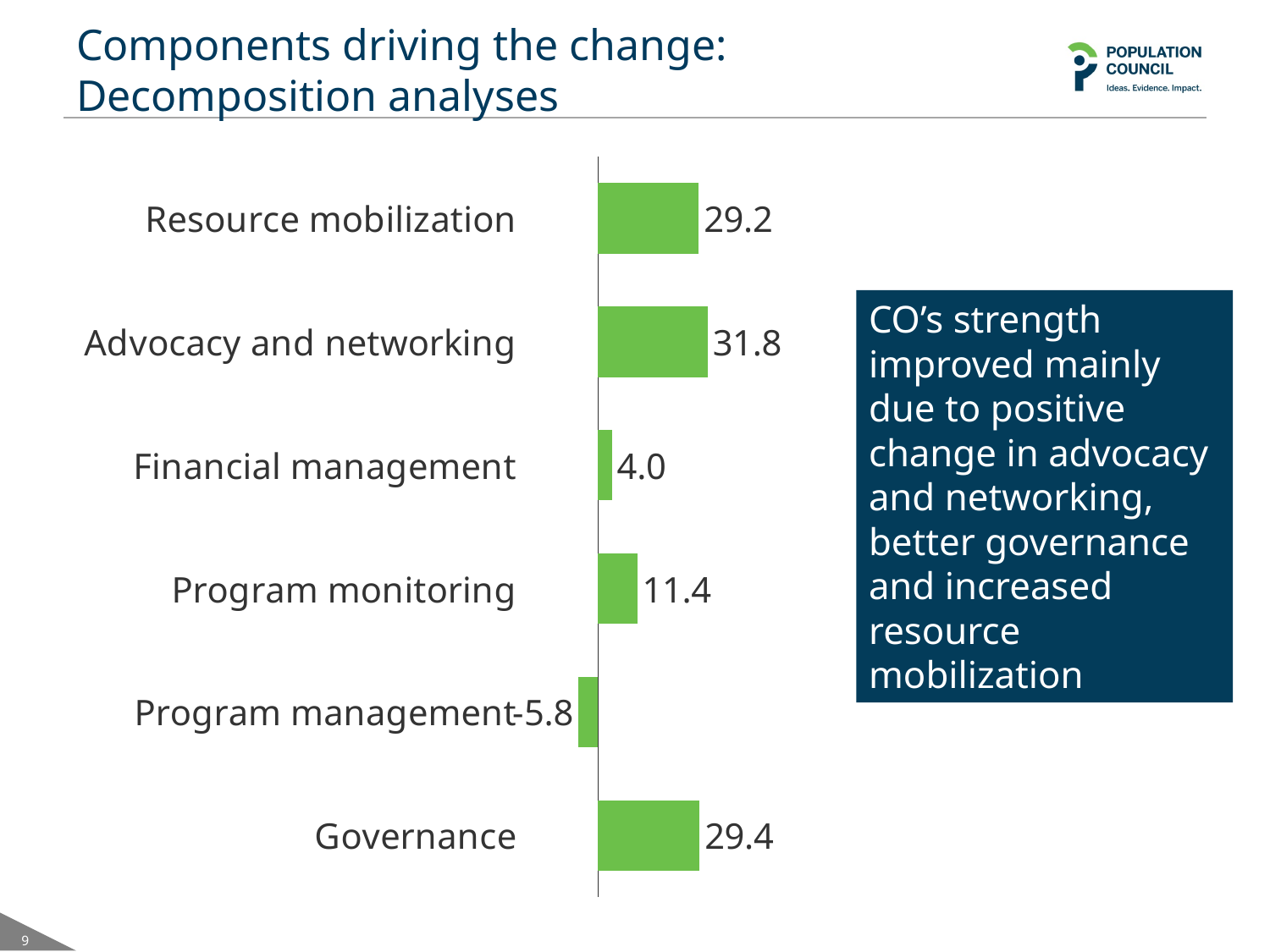
What is the value for Governance? 29.4 Which category is the only one with a negative value? Program management Which is larger, the value for Governance or the value for Program monitoring? Governance How many categories are shown in the chart? 6 What is the value for Financial management? 4.0 What is the value for Program management? -5.8 Which category has the lowest value? Program management What is the difference between the values for Program monitoring and Financial management? 7.4 What is the value for Advocacy and networking? 31.8 What is the difference between the values for Advocacy and networking and Resource mobilization? 2.6 What kind of chart is shown on the slide? Bar chart Which category has the highest value? Advocacy and networking